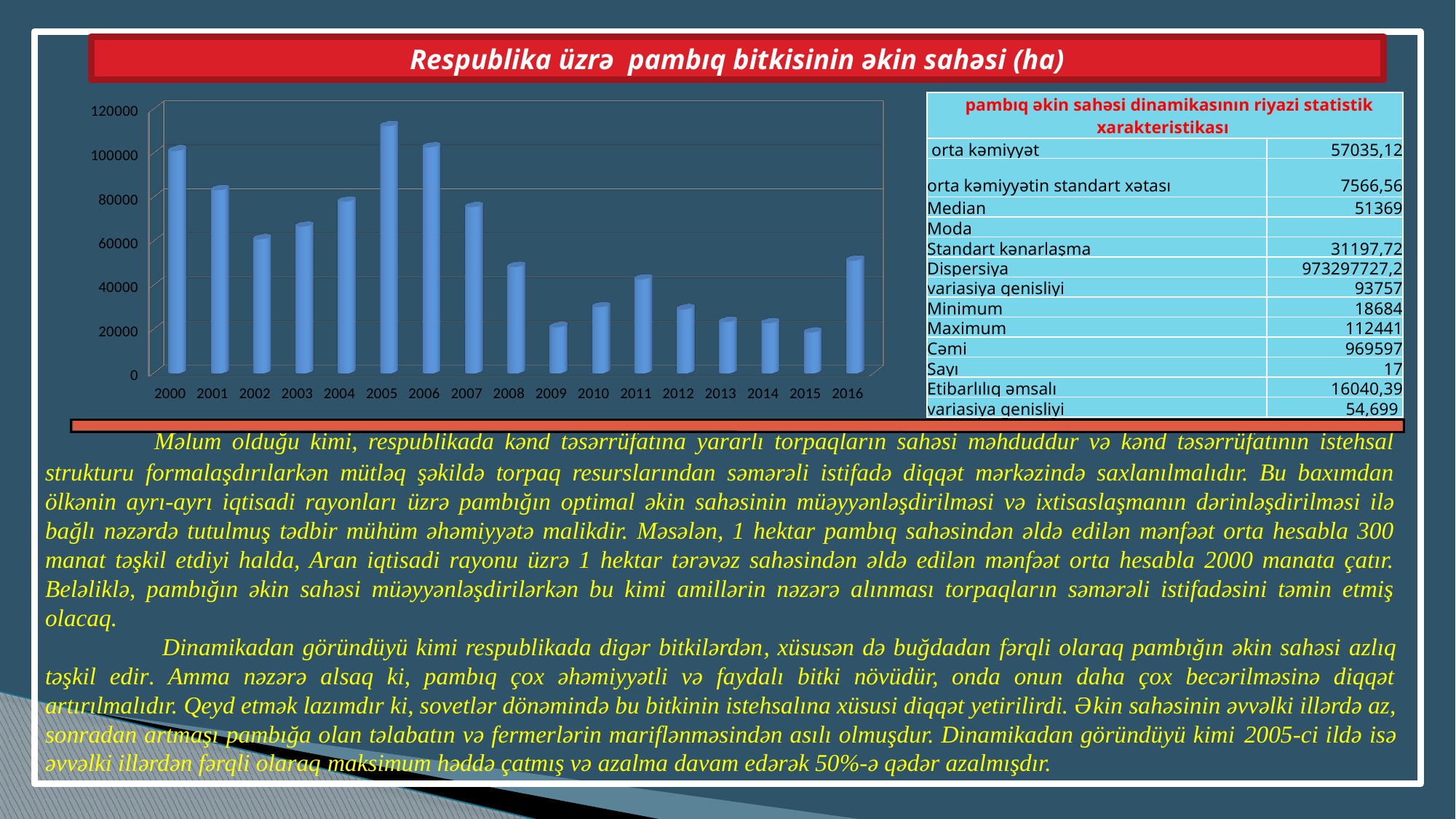
Which year has the lowest bar in the chart? 2015 Is the value for 2008 greater or less than 40000? greater Which is larger, the value for 2000 or the value for 2005? 2005 How many years are plotted on the x axis of the chart? 17 Which year has the highest bar in the chart? 2005 Is the value for 2007 greater or less than 80000? less What kind of chart is shown on the slide? bar chart Do the values generally rise or fall from 2005 to 2015? fall What is the title of the chart? Respublika üzrə pambıq bitkisinin əkin sahəsi (ha) Is the value for 2012 greater or less than 40000? less